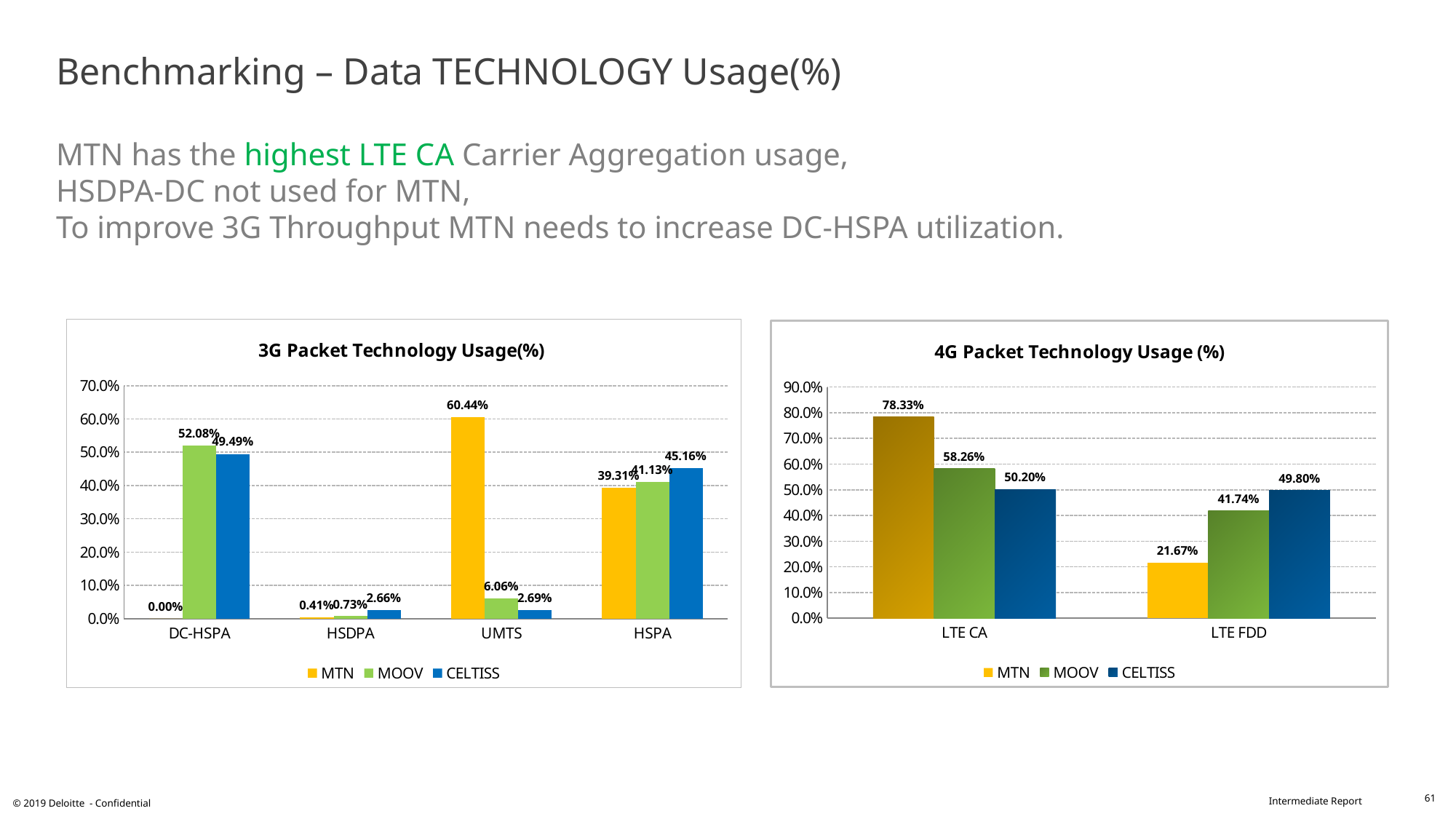
In the 4G Packet Technology Usage (%) chart, which operator has the highest LTE CA usage? MTN In the 4G Packet Technology Usage (%) chart, what is the difference between the MTN values for LTE CA and LTE FDD? 56.66% In the 4G Packet Technology Usage (%) chart, is the CELTISS value for LTE FDD greater or less than 40.0%? greater In the 4G Packet Technology Usage (%) chart, what is the MOOV value for LTE FDD? 41.74% How many series does the legend of the 4G Packet Technology Usage (%) chart list? 3 How many categories are shown on the x axis of the 3G Packet Technology Usage(%) chart? 4 In the 3G Packet Technology Usage(%) chart, what is the MTN value for UMTS? 60.44% In the 3G Packet Technology Usage(%) chart, which operator has the lowest DC-HSPA usage? MTN In the 3G Packet Technology Usage(%) chart, what is the difference between the MOOV and CELTISS values for DC-HSPA? 2.59% What type of chart is the 4G Packet Technology Usage (%) chart? Bar chart In the 3G Packet Technology Usage(%) chart, what is the CELTISS value for HSPA? 45.16% In the 3G Packet Technology Usage(%) chart, which is larger for HSPA: the MTN value or the MOOV value? MOOV